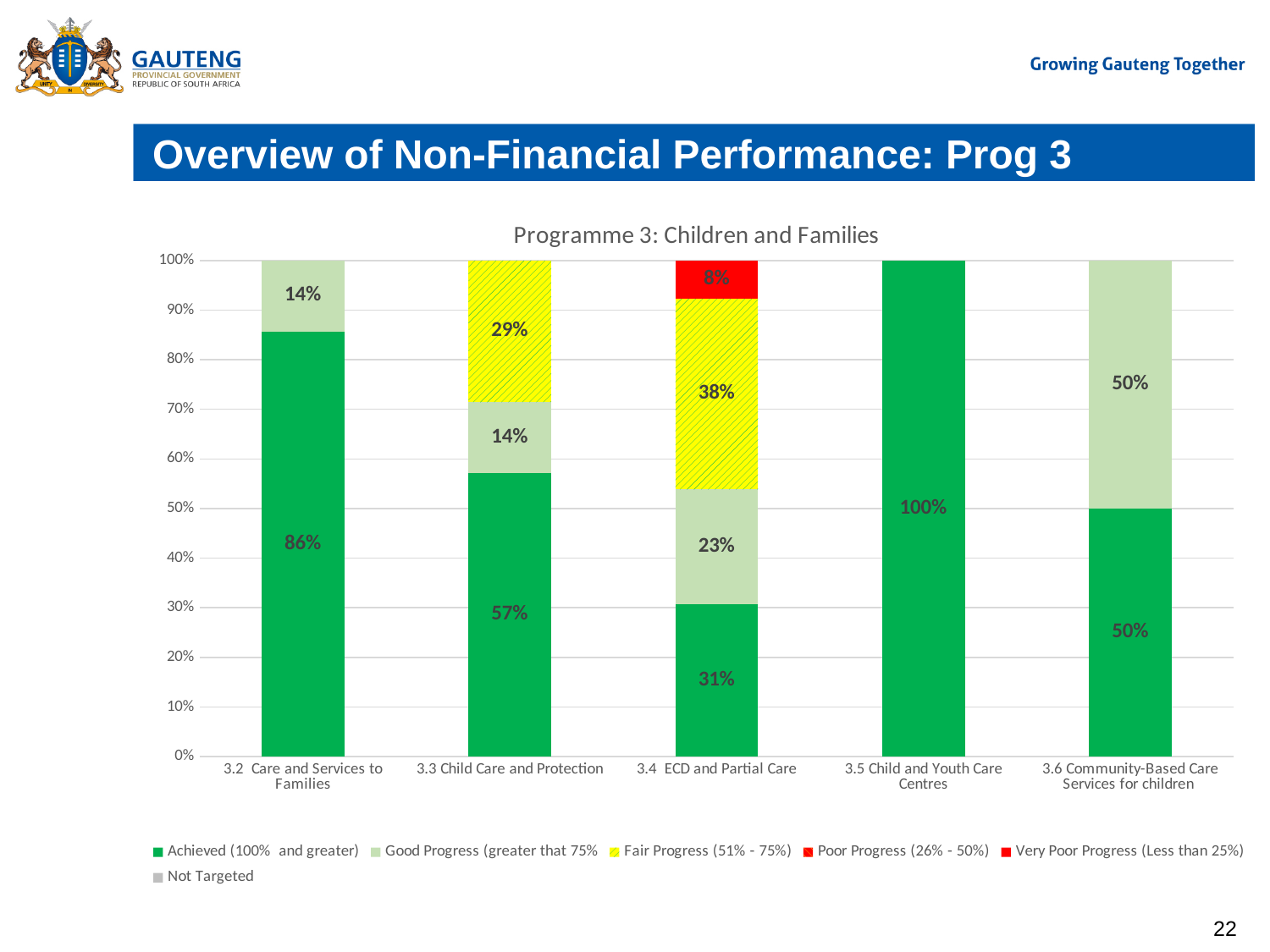
How many categories (sub-programmes) are shown on the x axis? 5 What is the Fair Progress (51% - 75%) value for 3.3 Child Care and Protection? 29% What is the difference between the Achieved values for 3.2 Care and Services to Families and 3.3 Child Care and Protection? 29% How many series does the legend list? 6 What is the Good Progress (greater that 75%) value for 3.4 ECD and Partial Care? 23% Which category has the lowest Achieved (100% and greater) value? 3.4 ECD and Partial Care What is the Achieved (100% and greater) value for 3.2 Care and Services to Families? 86% What type of chart is shown on the slide? Stacked bar chart What is the title of the chart? Programme 3: Children and Families Which category has the highest Achieved (100% and greater) value? 3.5 Child and Youth Care Centres Which is larger: the Fair Progress value for 3.4 ECD and Partial Care or the Fair Progress value for 3.3 Child Care and Protection? 3.4 ECD and Partial Care Is the Achieved value for 3.6 Community-Based Care Services for children greater or less than 80%? less